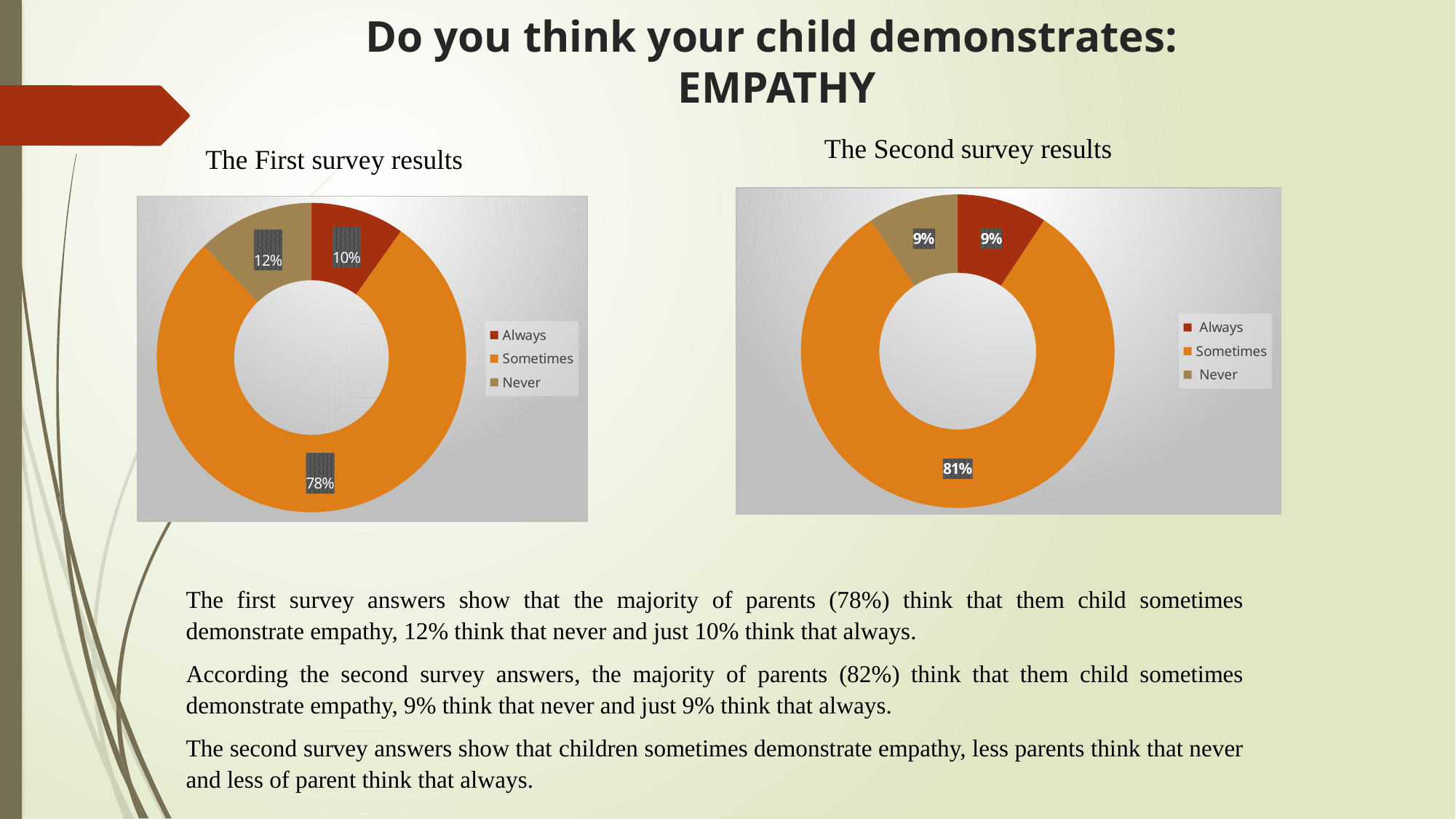
In the First survey results chart, which is larger, the Never share or the Always share? Never How many categories does the Second survey results chart show? 3 In the First survey results chart, what percentage of parents answered Never? 12% In the First survey results chart, which answer has the largest share? Sometimes In the First survey results chart, which answer has the smallest share? Always In the Second survey results chart, what is the difference between the Sometimes and Always shares? 72% What type of chart is used for the First survey results? Doughnut chart In the First survey results chart, what percentage of parents answered Sometimes? 78% In the First survey results chart, what is the difference between the Sometimes and Never shares? 66% In the Second survey results chart, what percentage of parents answered Always? 9% What are the legend entries in the Second survey results chart? Always, Sometimes, Never In the Second survey results chart, what percentage of parents answered Sometimes? 81%